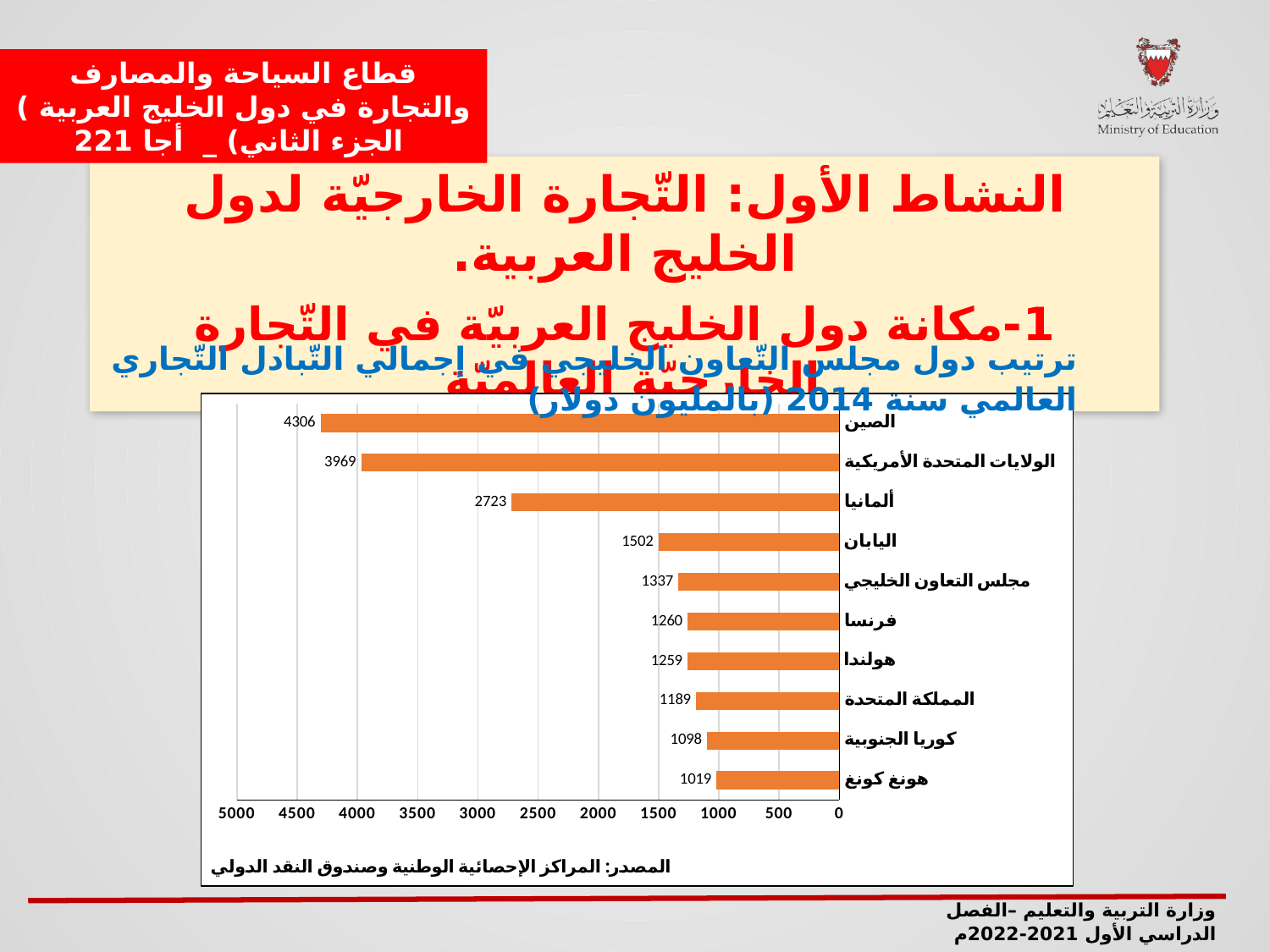
What is the value for الصين (China)? 4306 What source is cited below the chart? المصدر: المراكز الإحصائية الوطنية وصندوق النقد الدولي What kind of chart is shown on the slide? bar chart What is the value for مجلس التعاون الخليجي (GCC)? 1337 Which category has the highest value? الصين How many categories are shown in the chart? 10 Is the value for الولايات المتحدة الأمريكية greater or less than 3500? greater What is the value for ألمانيا (Germany)? 2723 Which category has the lowest value? هونغ كونغ What is the difference between the values for اليابان and مجلس التعاون الخليجي? 165 What is the difference between the values for الصين and الولايات المتحدة الأمريكية? 337 Which is larger, the value for ألمانيا or the value for اليابان? ألمانيا